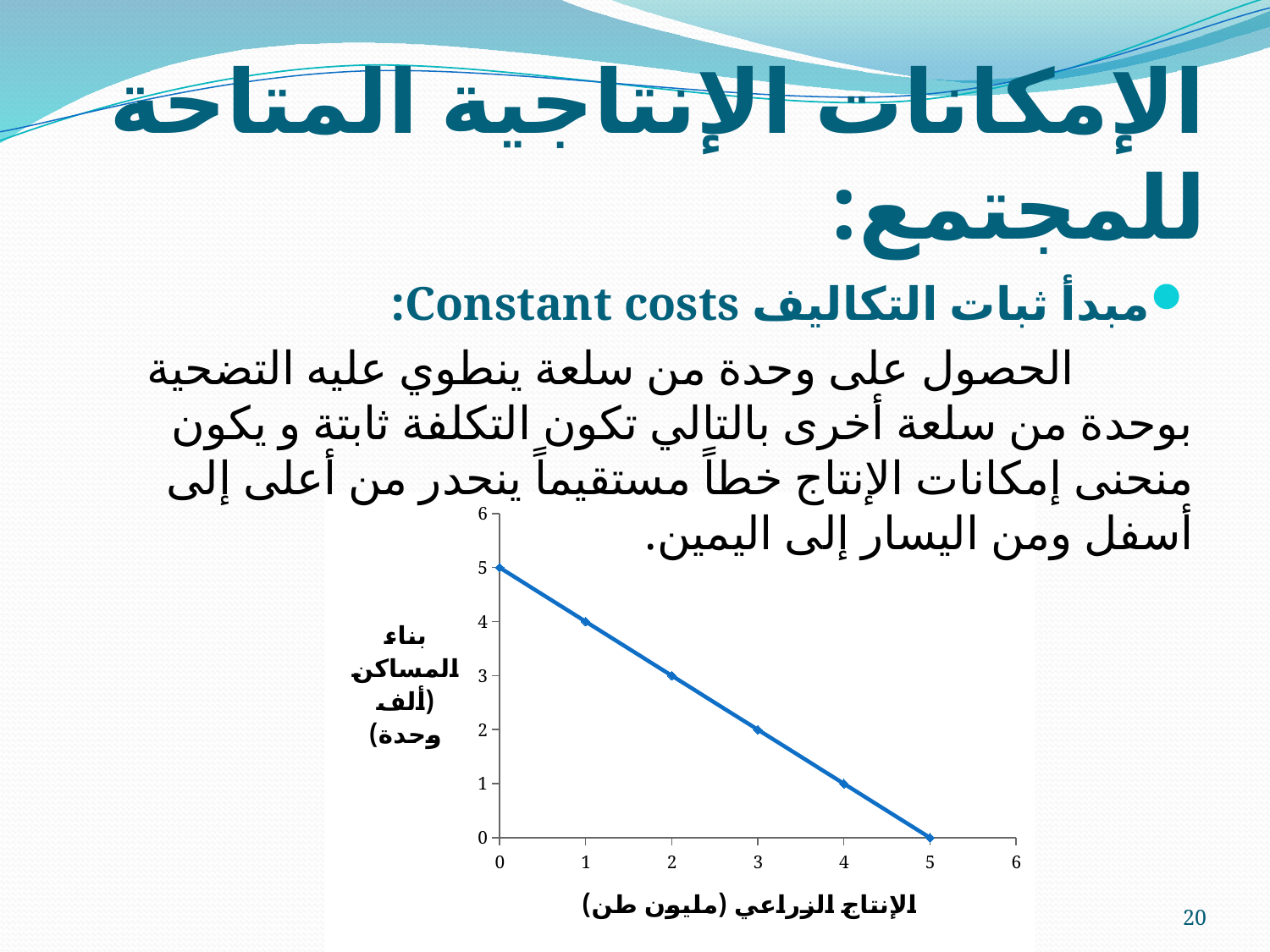
What is the label of the y axis of the chart? بناء المساكن (ألف وحدة) How many data points are plotted on the line? 6 What is the difference in بناء المساكن between الإنتاج الزراعي of 1 and الإنتاج الزراعي of 4? 3 What kind of chart is shown on the slide? line chart Which is larger: بناء المساكن at الإنتاج الزراعي of 2 or at الإنتاج الزراعي of 4? at 2 Do the values of بناء المساكن rise or fall as الإنتاج الزراعي increases along the x axis? fall What is the label of the x axis of the chart? الإنتاج الزراعي (مليون طن) At which value of الإنتاج الزراعي (مليون طن) is بناء المساكن lowest? 5 What is the value of بناء المساكن (ألف وحدة) when الإنتاج الزراعي (مليون طن) is 5? 0 What is the value of بناء المساكن (ألف وحدة) when الإنتاج الزراعي (مليون طن) is 3? 2 What is the value of بناء المساكن (ألف وحدة) when الإنتاج الزراعي (مليون طن) is 0? 5 At which value of الإنتاج الزراعي (مليون طن) is بناء المساكن highest? 0